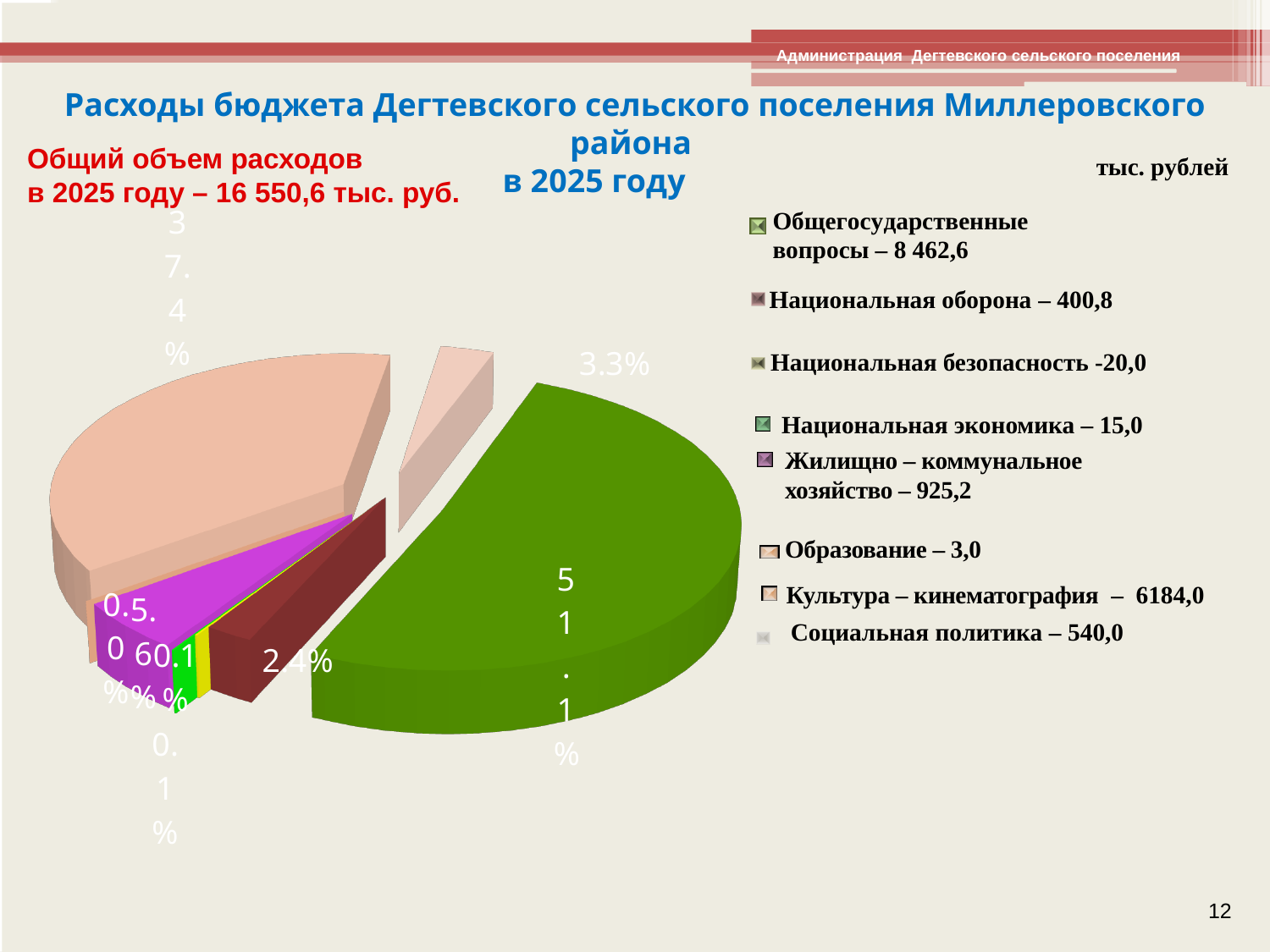
What is the difference between Жилищно – коммунальное хозяйство and Социальная политика? 385,2 How many expenditure categories does the legend of the pie chart list? 8 Which category has the largest expenditure? Общегосударственные вопросы What percentage share of the pie does the largest slice (Общегосударственные вопросы) have? 51.1% What is the difference between Общегосударственные вопросы and Культура – кинематография? 2278,6 What is the value shown for Жилищно – коммунальное хозяйство? 925,2 Which is larger: Национальная оборона or Социальная политика? Социальная политика What is the total volume of expenditures in 2025 stated on the slide? 16 550,6 тыс. руб. What is the value shown for Общегосударственные вопросы? 8 462,6 What kind of chart is shown on the slide? pie chart What is the value shown for Культура – кинематография? 6184,0 Which category has the smallest expenditure? Образование